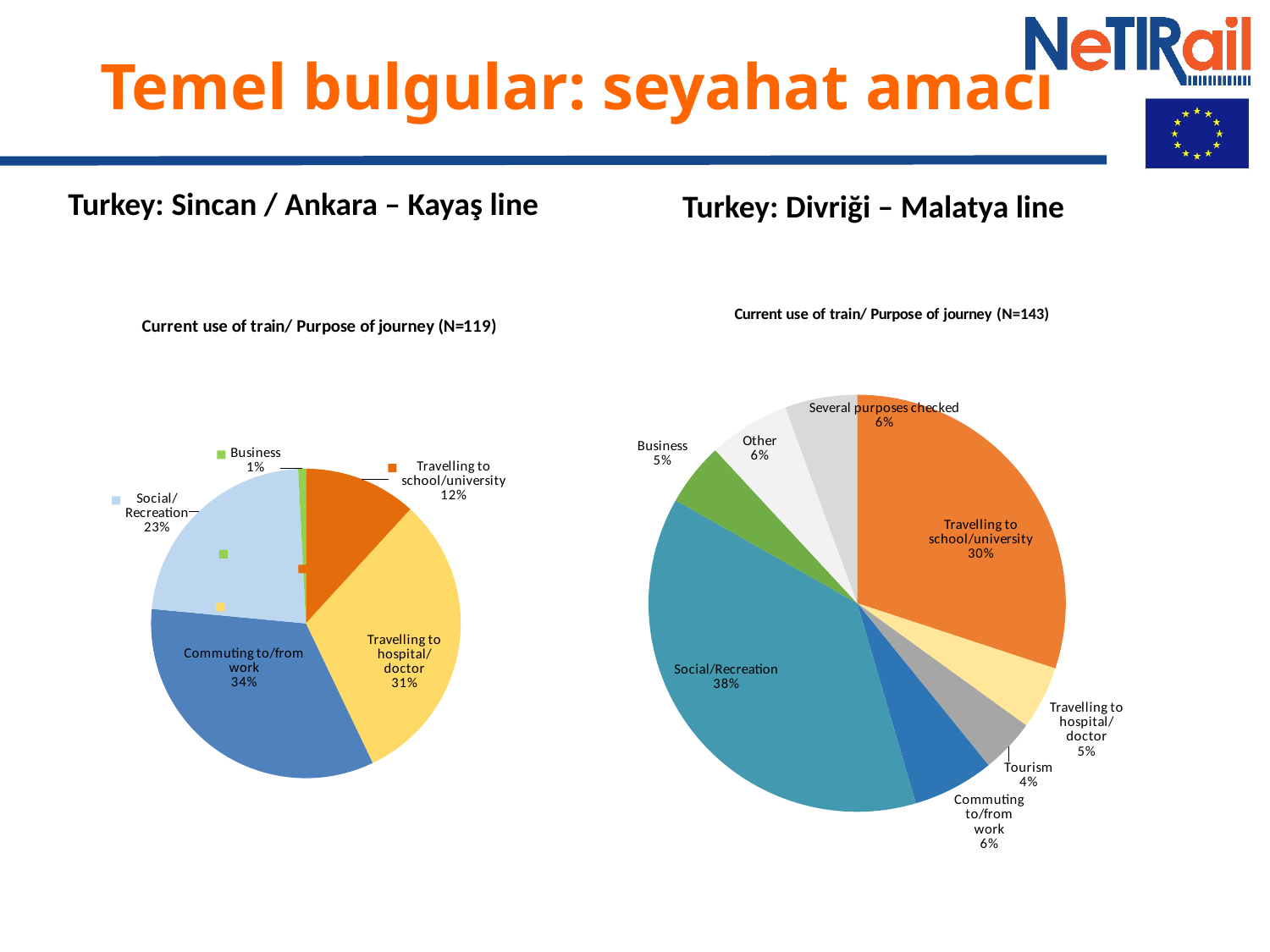
In the Sincan / Ankara – Kayaş line chart, what share of journeys is for commuting to/from work? 34% In the Divriği – Malatya line chart, which purpose of journey has the largest share? Social/Recreation In the Divriği – Malatya line chart, what share of journeys is for Social/Recreation? 38% In the Sincan / Ankara – Kayaş line chart, what is the difference between the Social/Recreation share and the Travelling to school/university share? 11 percentage points What type of chart is used for the Divriği – Malatya line data? Pie chart How many slices does the Divriği – Malatya line pie chart have? 8 In the Sincan / Ankara – Kayaş line chart, which purpose of journey has the smallest share? Business In the Divriği – Malatya line chart, what share of journeys is for Tourism? 4% In the Sincan / Ankara – Kayaş line chart, which purpose of journey has the largest share? Commuting to/from work In the Divriği – Malatya line chart, which is larger: Travelling to school/university or Commuting to/from work? Travelling to school/university In the Sincan / Ankara – Kayaş line chart, what share of journeys is for travelling to hospital/doctor? 31% How many slices does the Sincan / Ankara – Kayaş line pie chart have? 5